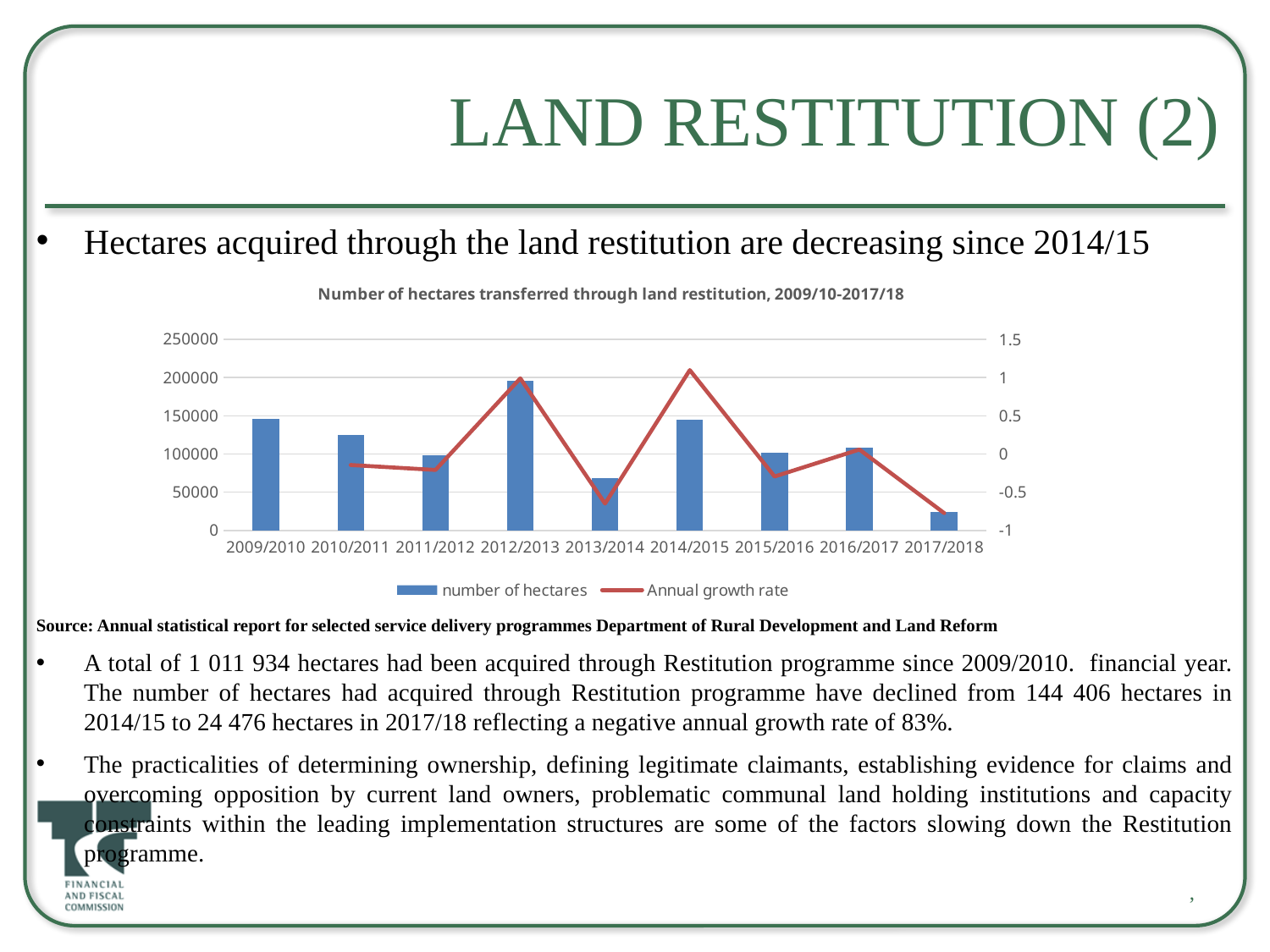
What is the title of the chart? Number of hectares transferred through land restitution, 2009/10-2017/18 Do the number of hectares rise or fall from 2014/2015 to 2017/2018? fall Which has more hectares transferred, 2009/2010 or 2013/2014? 2009/2010 Which financial year has the highest number of hectares transferred? 2012/2013 What kind of chart is shown on the slide? A combination bar and line chart Is the number of hectares for 2010/2011 greater or less than 100000? greater How many financial years are shown on the x axis of the chart? 9 How many series does the chart's legend list? 2 Is the annual growth rate for 2017/2018 greater or less than -0.5? less Is the number of hectares for 2017/2018 greater or less than 50000? less Which financial year has the lowest number of hectares transferred? 2017/2018